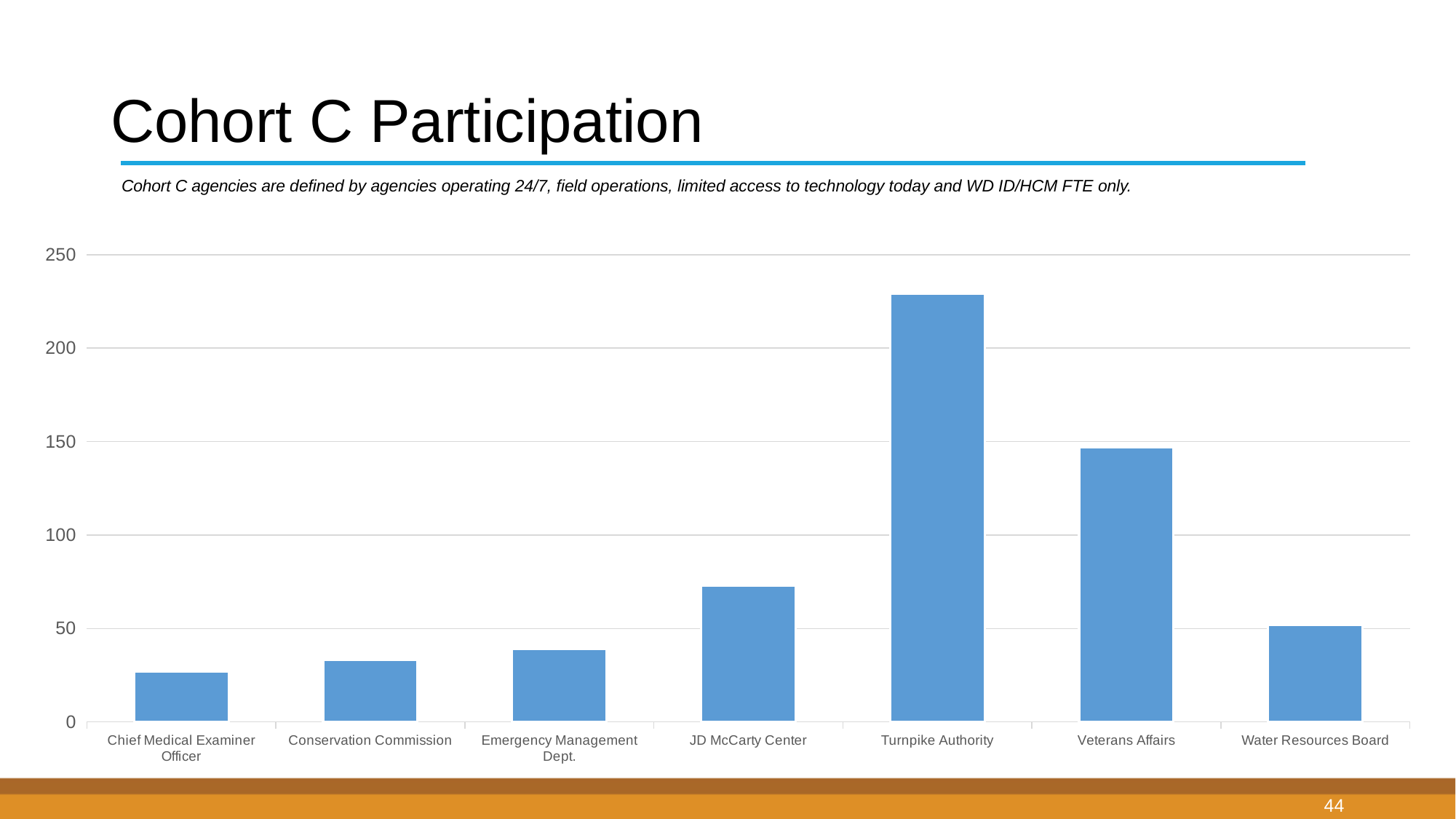
Is the value for Veterans Affairs greater or less than 100? greater What is the title of the slide containing the chart? Cohort C Participation Is the value for JD McCarty Center greater or less than 50? greater Which agency has the lowest bar in the chart? Chief Medical Examiner Officer Which has the larger value, Water Resources Board or Emergency Management Dept.? Water Resources Board What kind of chart is shown on the slide? bar chart Is the value for JD McCarty Center greater or less than 100? less How many agencies are shown on the x axis of the chart? 7 Which agency has the highest bar in the chart? Turnpike Authority Which has the larger value, Veterans Affairs or JD McCarty Center? Veterans Affairs